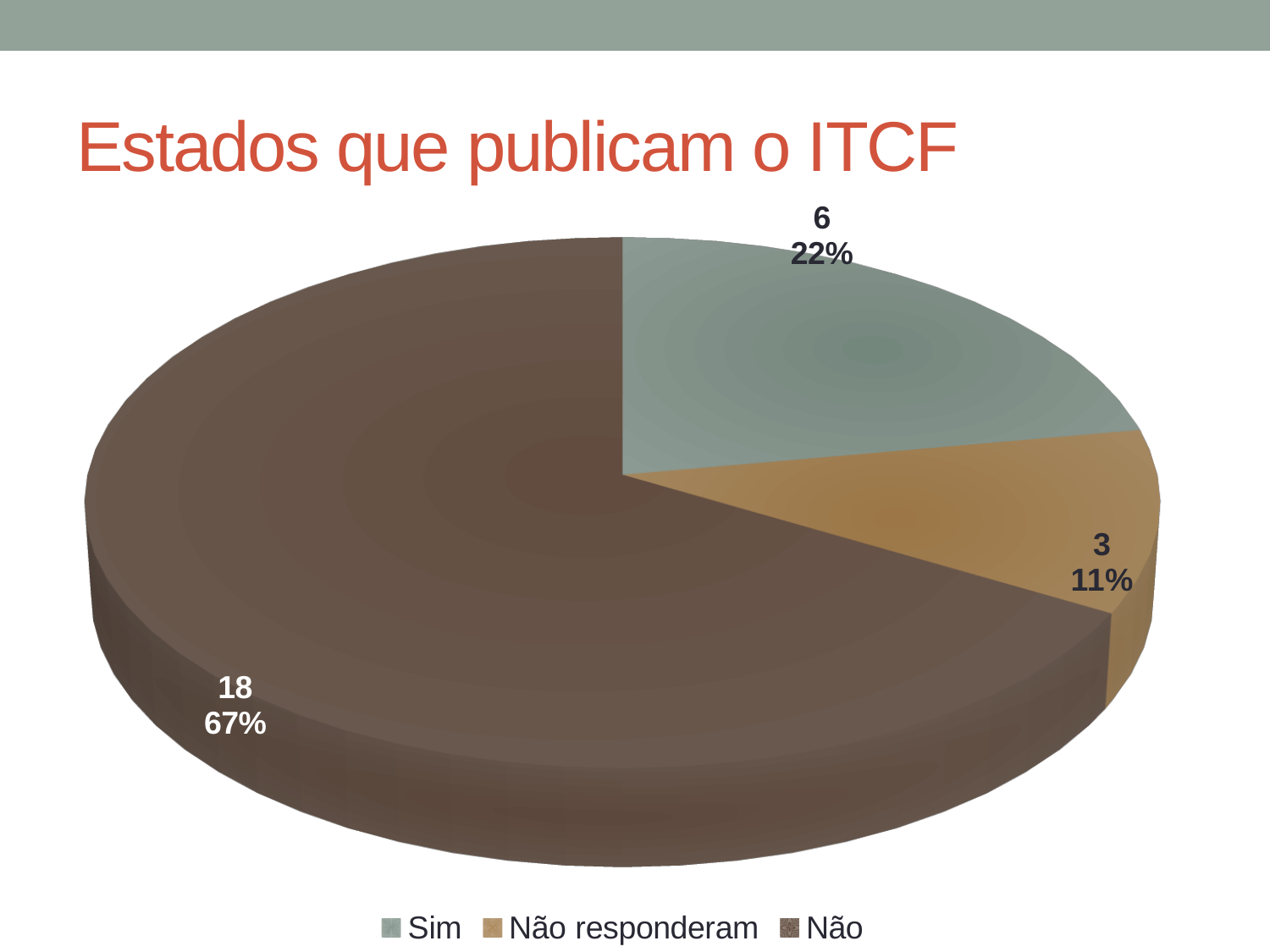
What is the title of the chart? Estados que publicam o ITCF What share of the pie does "Não responderam" represent? 11% Which category has the largest slice? Não How many slices does the pie chart have? 3 What share of the pie does "Não" represent? 67% What is the value for "Não responderam"? 3 What kind of chart is shown on the slide? pie chart What share of the pie does "Sim" represent? 22% What is the difference between the values for "Não" and "Sim"? 12 Which category has the smallest slice? Não responderam What is the value for "Sim"? 6 What is the value for "Não"? 18